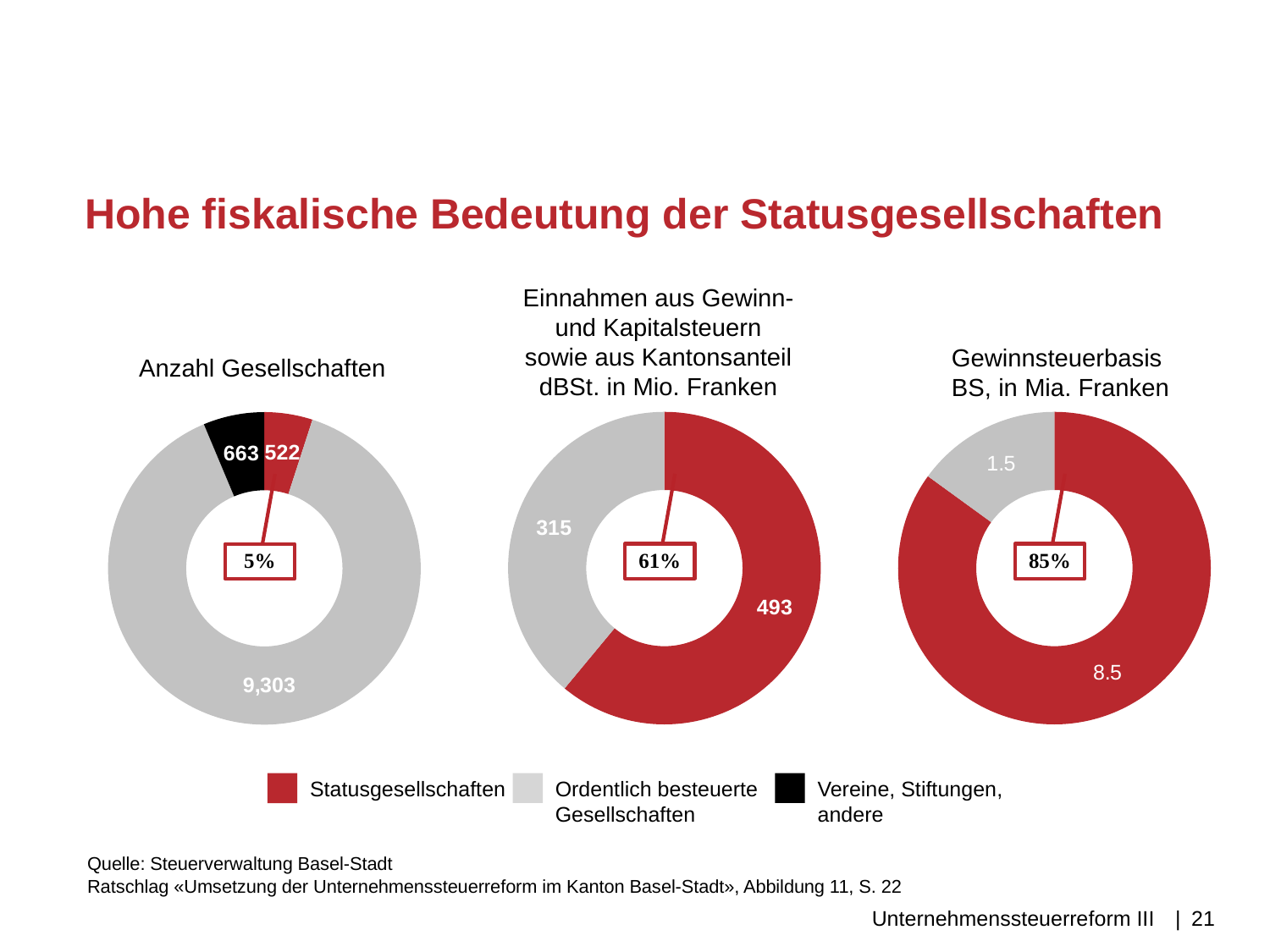
In the 'Anzahl Gesellschaften' chart, what is the value for Statusgesellschaften? 522 In the 'Gewinnsteuerbasis BS' chart, what is the value for Ordentlich besteuerte Gesellschaften? 1.5 In the middle chart (Einnahmen aus Gewinn- und Kapitalsteuern), what is the value for Statusgesellschaften? 493 In the 'Anzahl Gesellschaften' chart, what share of the total is labelled for Statusgesellschaften? 5% In the 'Anzahl Gesellschaften' chart, which category has the smallest value? Statusgesellschaften In the 'Anzahl Gesellschaften' chart, what is the value for Vereine, Stiftungen, andere? 663 In the middle chart (Einnahmen aus Gewinn- und Kapitalsteuern), what is the difference between Statusgesellschaften and Ordentlich besteuerte Gesellschaften? 178 What kind of chart is used for 'Anzahl Gesellschaften'? Donut (pie) chart How many series does the legend list? 3 In the 'Gewinnsteuerbasis BS' chart, which is larger: Statusgesellschaften or Ordentlich besteuerte Gesellschaften? Statusgesellschaften In the 'Anzahl Gesellschaften' chart, what is the value for Ordentlich besteuerte Gesellschaften? 9,303 In the middle chart (Einnahmen aus Gewinn- und Kapitalsteuern), what share is labelled for Statusgesellschaften? 61%